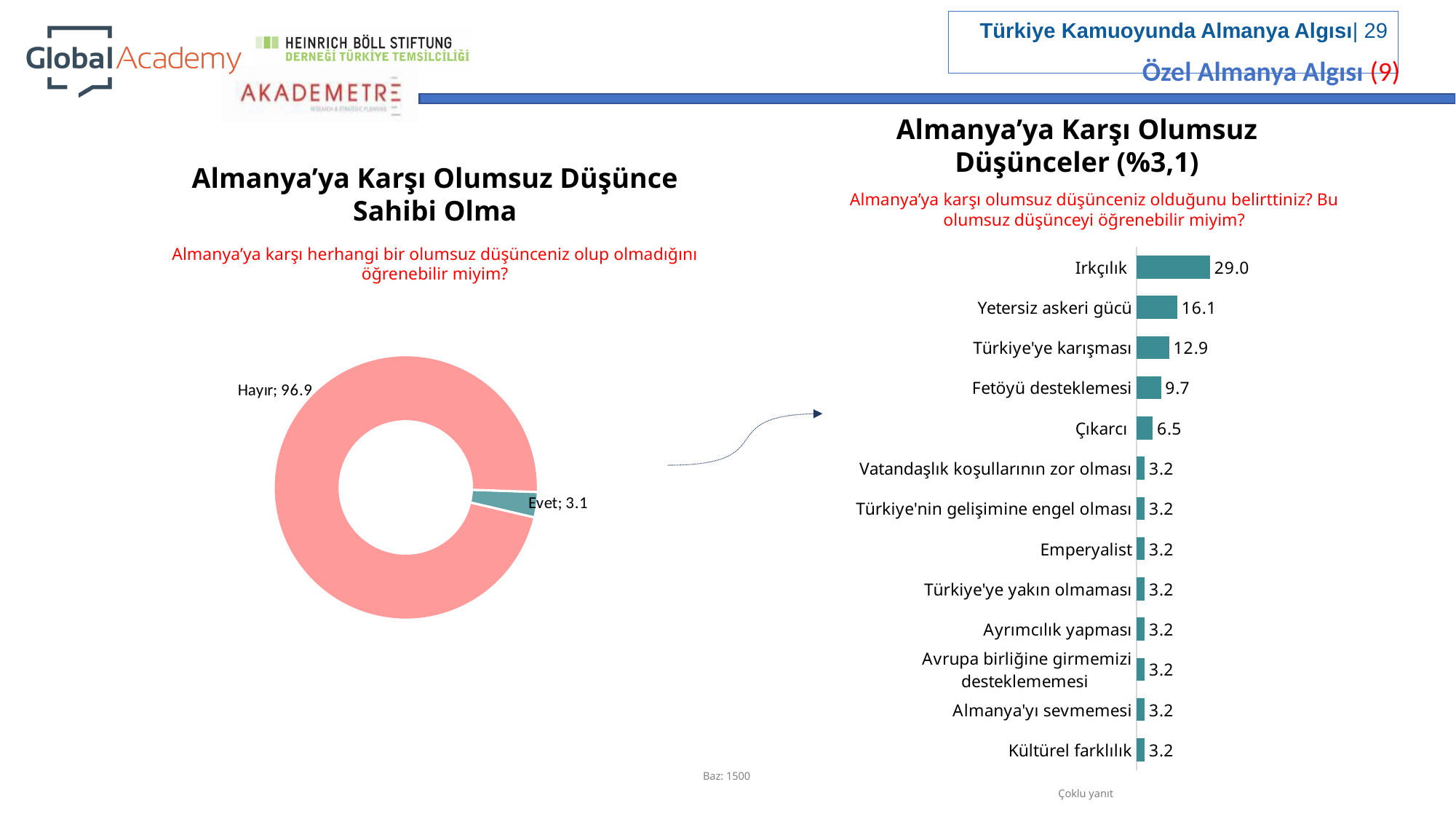
What kind of chart is the one titled "Almanya'ya Karşı Olumsuz Düşünce Sahibi Olma"? Doughnut chart In the chart titled "Almanya'ya Karşı Olumsuz Düşünce Sahibi Olma", what is the difference between the values for Hayır and Evet? 93.8 What kind of chart is the one titled "Almanya'ya Karşı Olumsuz Düşünceler (%3,1)"? Bar chart In the chart titled "Almanya'ya Karşı Olumsuz Düşünceler (%3,1)", which category has the highest value? Irkçılık In the chart titled "Almanya'ya Karşı Olumsuz Düşünceler (%3,1)", what is the difference between the values for Irkçılık and Yetersiz askeri gücü? 12.9 In the chart titled "Almanya'ya Karşı Olumsuz Düşünceler (%3,1)", what is the value for Irkçılık? 29.0 In the chart titled "Almanya'ya Karşı Olumsuz Düşünce Sahibi Olma", what is the value for Evet? 3.1 In the chart titled "Almanya'ya Karşı Olumsuz Düşünceler (%3,1)", what is the value for Fetöyü desteklemesi? 9.7 In the chart titled "Almanya'ya Karşı Olumsuz Düşünceler (%3,1)", what is the value for Kültürel farklılık? 3.2 In the chart titled "Almanya'ya Karşı Olumsuz Düşünceler (%3,1)", how many categories are shown? 13 In the chart titled "Almanya'ya Karşı Olumsuz Düşünceler (%3,1)", which is larger, the value for Türkiye'ye karışması or the value for Çıkarcı? Türkiye'ye karışması In the chart titled "Almanya'ya Karşı Olumsuz Düşünce Sahibi Olma", what is the value for Hayır? 96.9